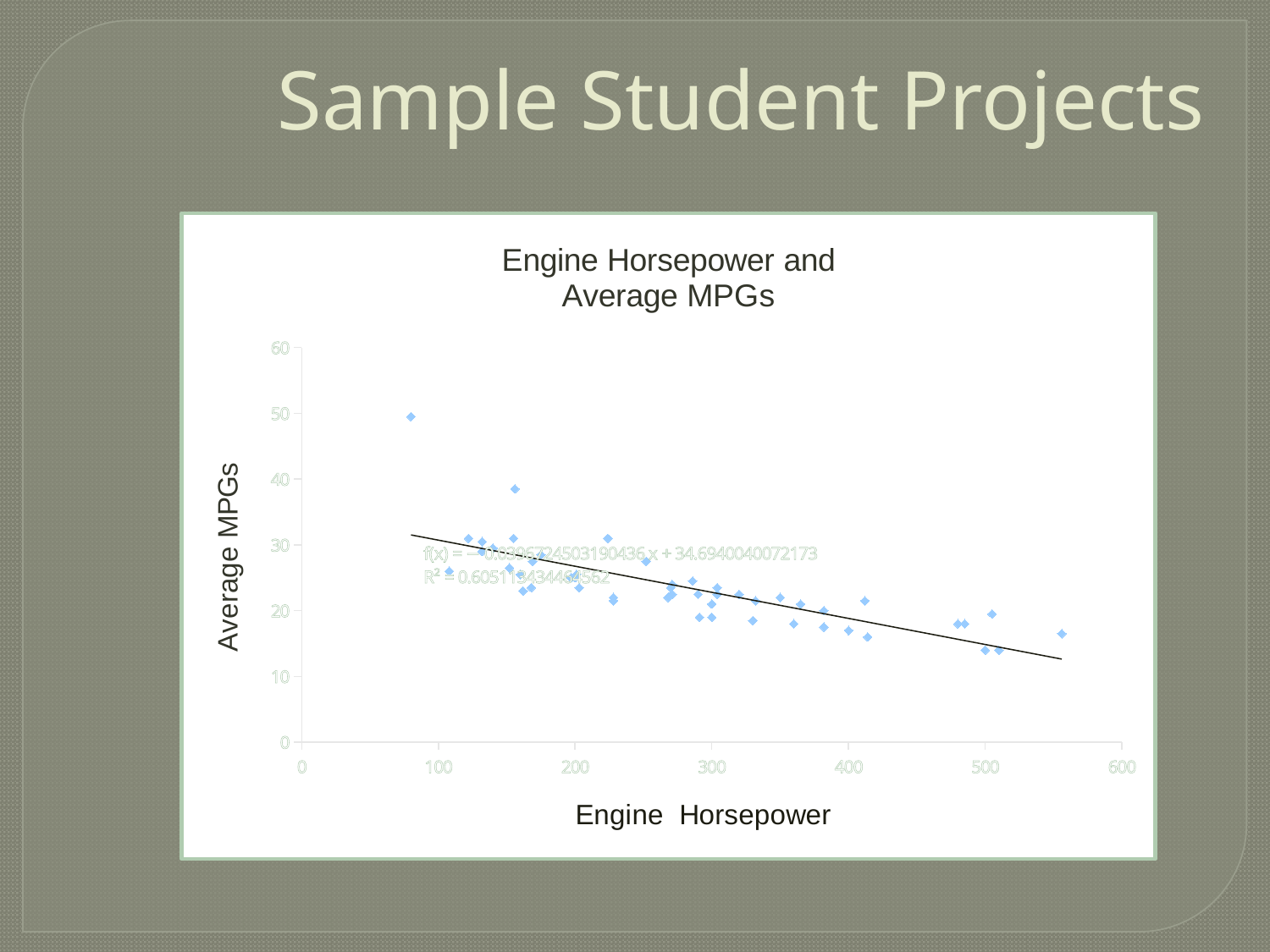
Is the Average MPGs value for the point at about 80 horsepower greater or less than 30? greater Is the Average MPGs value for the point at about 155 horsepower (the second-highest point) greater or less than 30? greater Which has the higher Average MPGs: the point near 80 horsepower or the point near 555 horsepower? The point near 80 horsepower Does the point with the highest Average MPGs lie at the low end or the high end of the Engine Horsepower axis? Low end As Engine Horsepower increases along the x axis, do the Average MPGs values generally rise or fall? Fall What is the label on the vertical axis of the chart? Average MPGs Is the highest plotted Average MPGs value greater or less than 40? greater Does the fitted trend line in the chart slope upward or downward from left to right? Downward What is the title of the chart? Engine Horsepower and Average MPGs What kind of chart is shown on the slide? Scatter plot